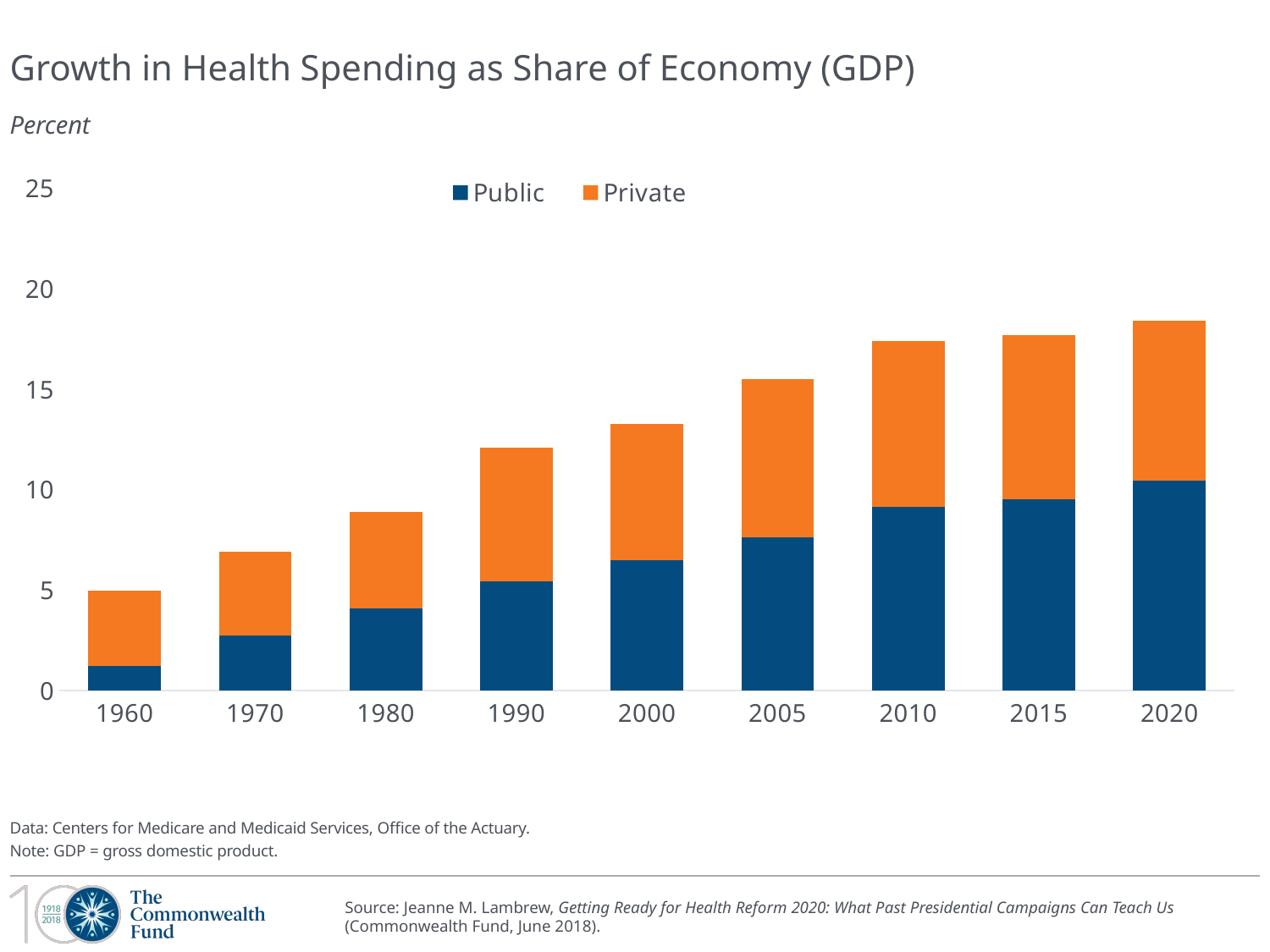
Is the total value for 2000 greater or less than 10? greater How many series does the legend list? 2 Is the Public value for 1960 greater or less than 5? less How many years are shown on the x axis? 9 Is the total value for 1980 greater or less than 10? less Which series is shown in orange? Private Which year has the highest total health spending as a share of GDP? 2020 What kind of chart is shown on the slide? Stacked bar chart Which is larger, the Public value for 2020 or the Public value for 1960? 2020 Do the total values rise or fall from 1960 to 2020? rise Which year has the lowest total health spending as a share of GDP? 1960